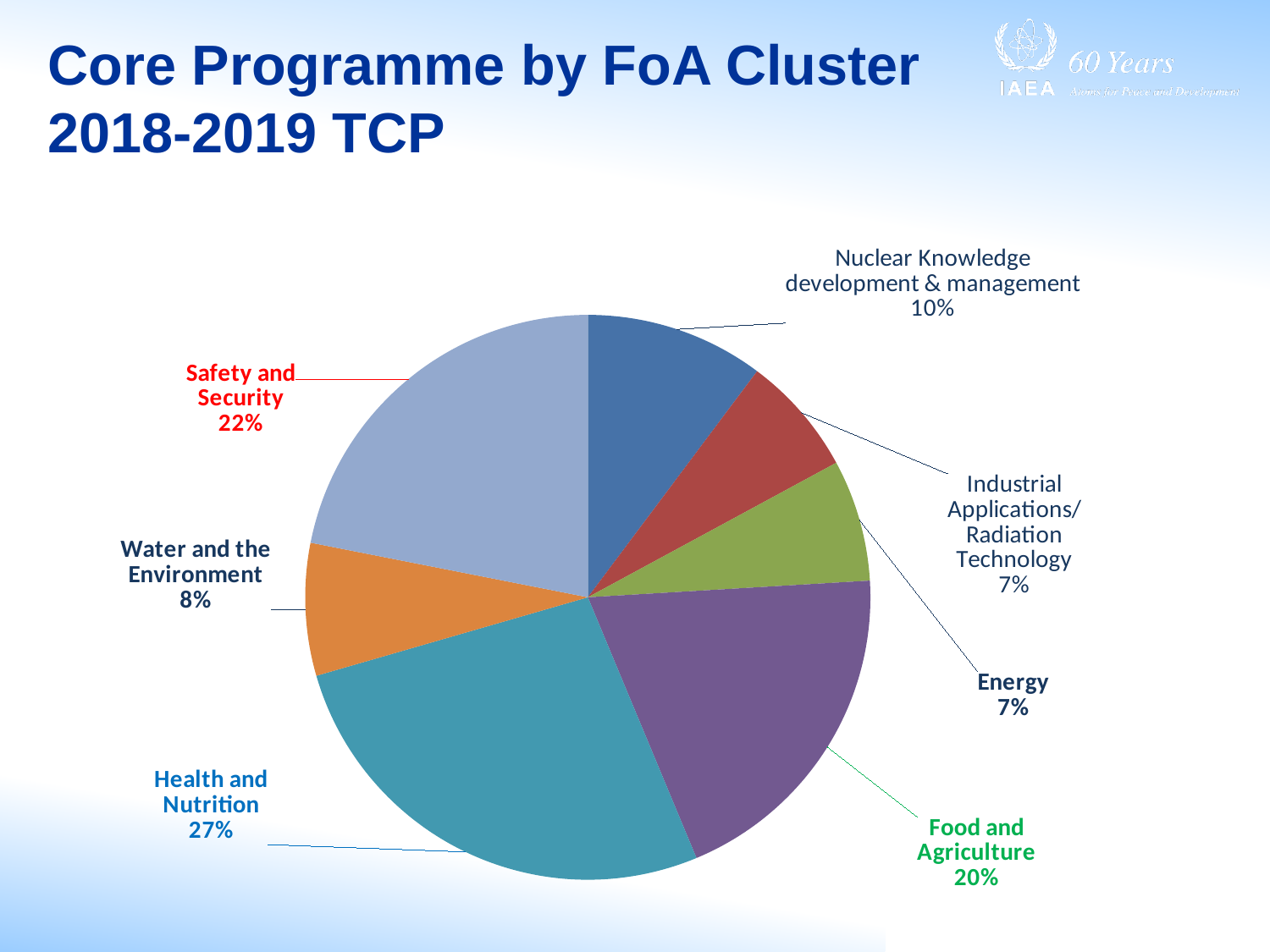
What percentage is shown for Water and the Environment? 8% What is the difference in percentage points between Health and Nutrition and Food and Agriculture? 7 What percentage is shown for Food and Agriculture? 20% What kind of chart is shown on the slide? Pie chart What is the value shown for Safety and Security? 22% How many slices does the pie chart have? 7 Which cluster has the largest share of the pie? Health and Nutrition What is the value for Nuclear Knowledge development & management? 10% What share of the pie does Health and Nutrition hold? 27% Which two clusters share the smallest value, 7%? Industrial Applications/Radiation Technology and Energy Which is larger, Safety and Security or Food and Agriculture? Safety and Security What is the title of the slide containing the chart? Core Programme by FoA Cluster 2018-2019 TCP